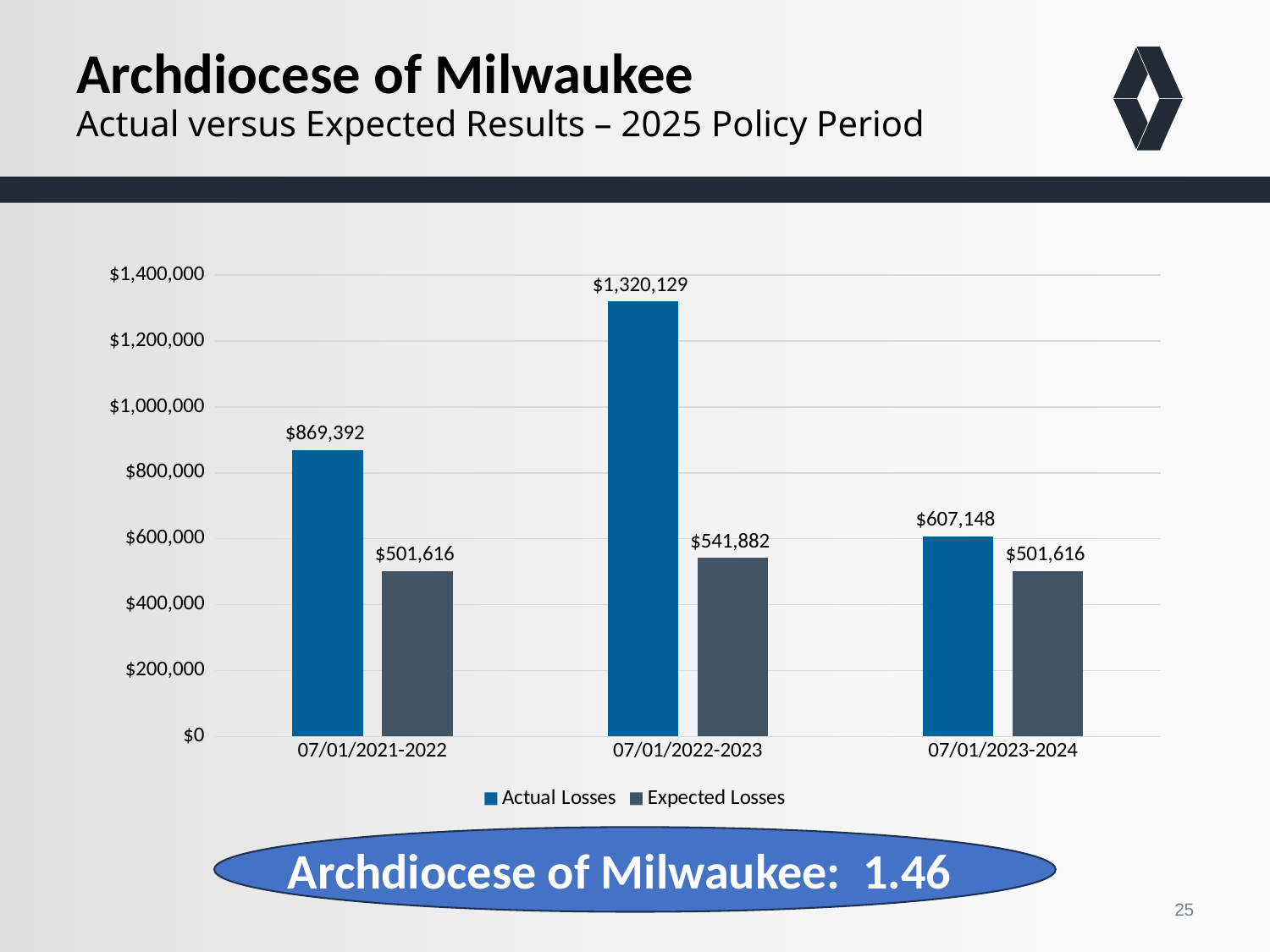
What kind of chart is shown on the slide? Bar chart What are the Actual Losses for 07/01/2022-2023? $1,320,129 Which policy period has the highest Actual Losses? 07/01/2022-2023 What are the Actual Losses for 07/01/2023-2024? $607,148 Which policy period has the lowest Actual Losses? 07/01/2023-2024 Are the Actual Losses for 07/01/2022-2023 greater or less than $1,200,000? greater What is the difference between Actual Losses and Expected Losses for 07/01/2021-2022? $367,776 What ratio is shown in the oval below the chart for the Archdiocese of Milwaukee? 1.46 What are the Expected Losses for 07/01/2021-2022? $501,616 Which is larger for 07/01/2023-2024, Actual Losses or Expected Losses? Actual Losses How many series does the legend list? 2 How many policy periods are shown on the x axis? 3